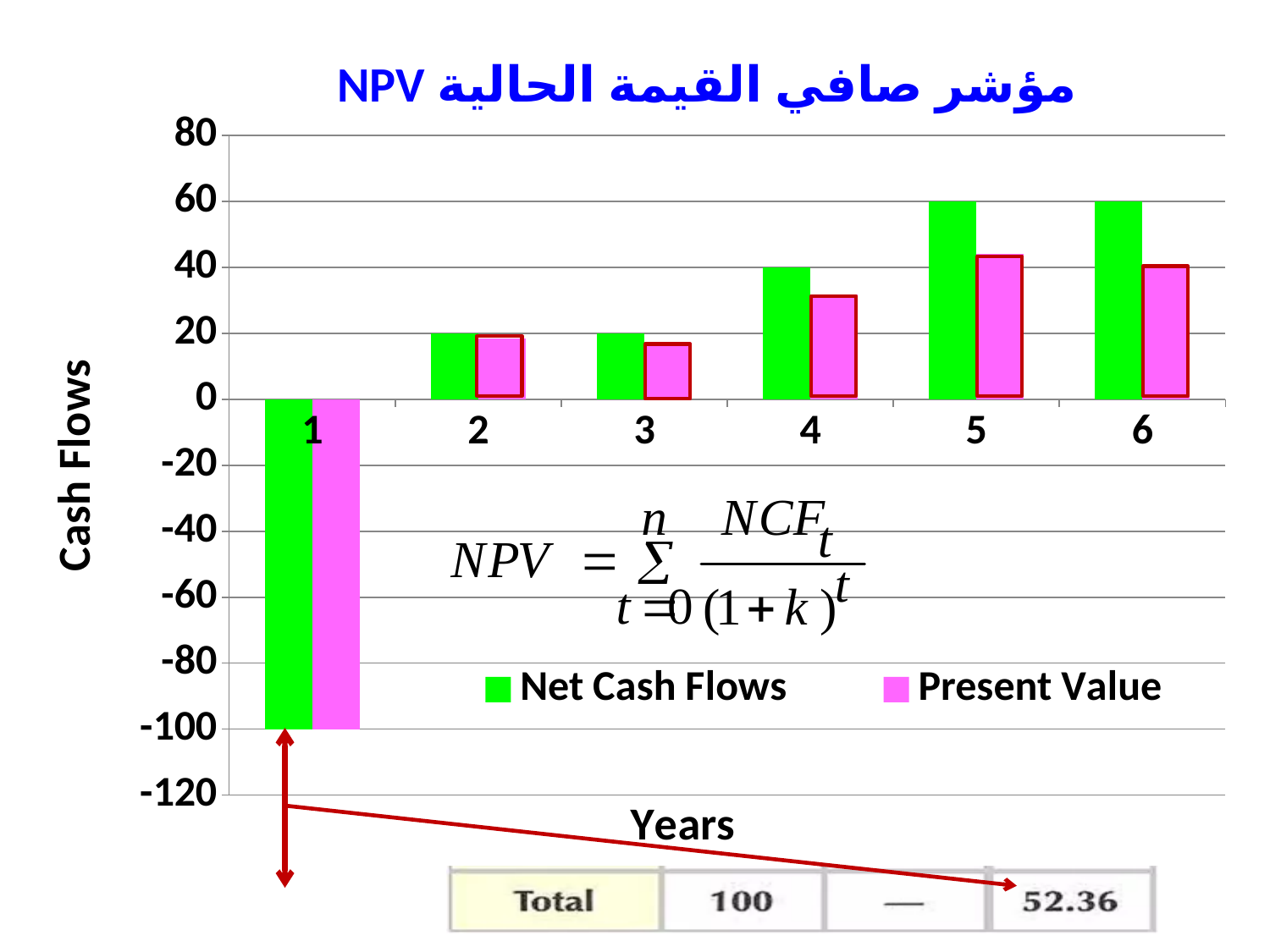
Which year has the lowest Net Cash Flows value? 1 Is the Present Value for year 3 greater or less than 20? less What is the Net Cash Flows value for year 1? -100 What is the title of the vertical axis? Cash Flows Do the Net Cash Flows values rise or fall from year 2 to year 5? rise In year 5, which is larger: Net Cash Flows or Present Value? Net Cash Flows What is the Net Cash Flows value for year 4? 40 How many series does the chart legend list? 2 What kind of chart is shown on the slide? bar chart How many years (categories) are plotted on the x axis? 6 Is the Present Value for year 5 greater or less than 40? greater What is the difference between the Net Cash Flows values for year 5 and year 2? 40